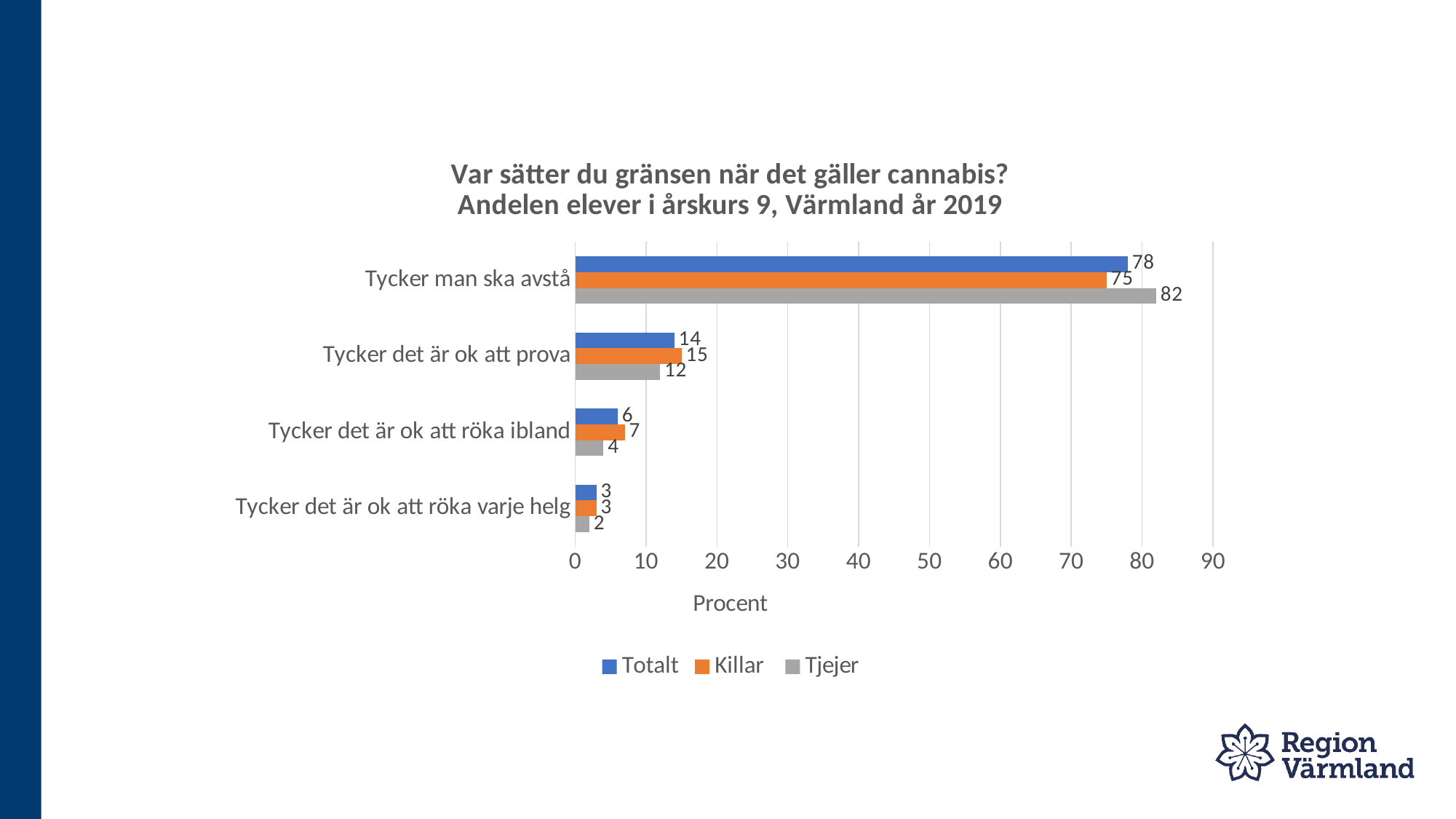
How many series does the legend list? 3 What is the value for Tjejer in the category "Tycker man ska avstå"? 82 Which category has the highest value for Totalt? Tycker man ska avstå What is the label of the x axis? Procent In the category "Tycker det är ok att prova", which series has the larger value, Killar or Tjejer? Killar What is the value for Totalt in the category "Tycker det är ok att röka ibland"? 6 Which category has the lowest value for Tjejer? Tycker det är ok att röka varje helg What kind of chart is shown on the slide? Bar chart What is the difference between the Tjejer and Killar values in the category "Tycker man ska avstå"? 7 How many categories are shown on the y axis? 4 What is the value for Killar in the category "Tycker det är ok att prova"? 15 Is the value for Totalt in "Tycker man ska avstå" greater or less than 70? greater